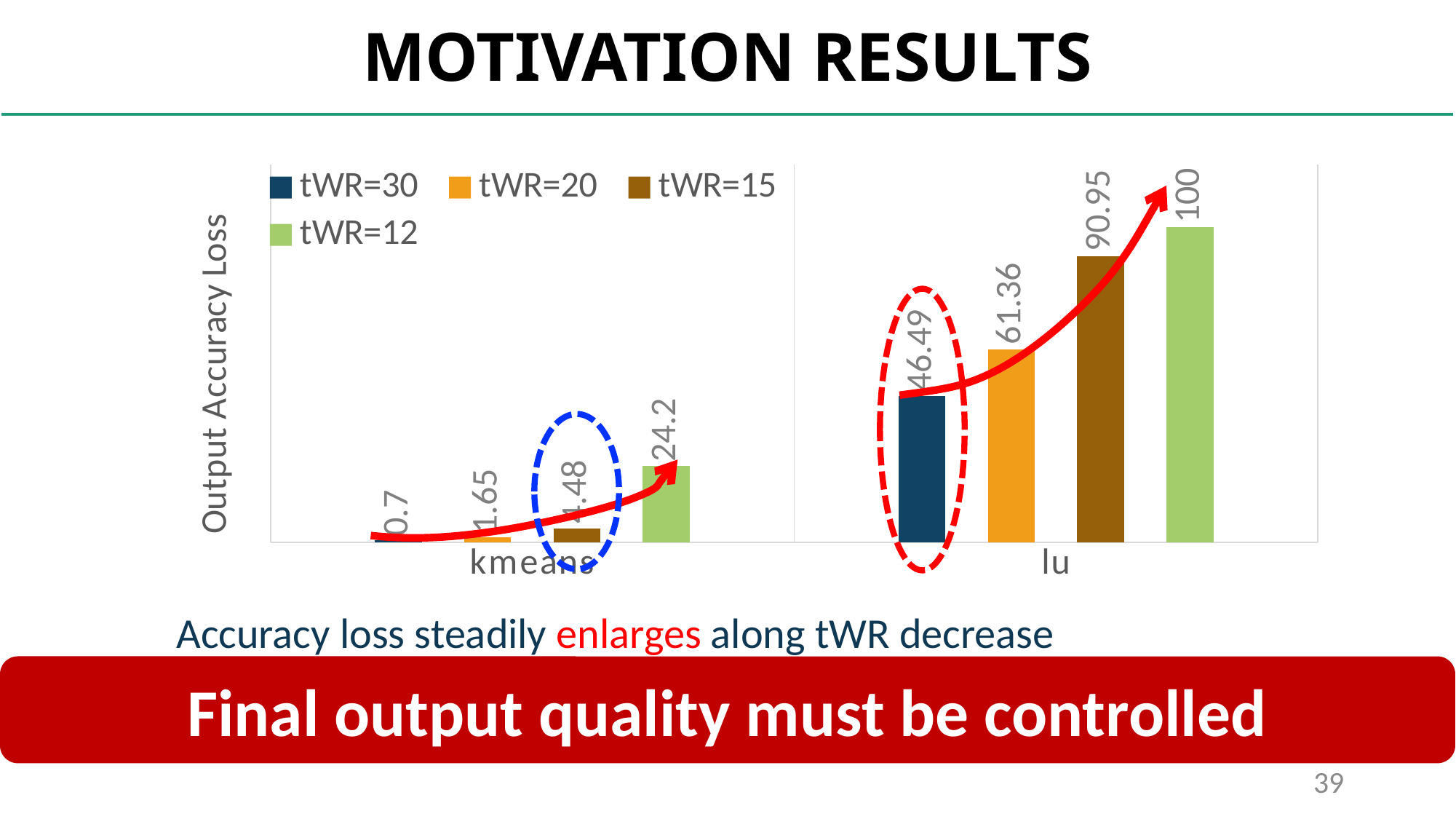
Which tWR setting gives the lowest Output Accuracy Loss for kmeans? tWR=30 How many categories are shown on the x axis? 2 What is the Output Accuracy Loss for lu at tWR=30? 46.49 What is the Output Accuracy Loss for lu at tWR=15? 90.95 What is the Output Accuracy Loss for lu at tWR=20? 61.36 What is the label of the y axis? Output Accuracy Loss How many series does the legend list? 4 Which tWR setting gives the highest Output Accuracy Loss for lu? tWR=12 What is the Output Accuracy Loss for kmeans at tWR=12? 24.2 What kind of chart is shown on the slide? bar chart Which is larger: the Output Accuracy Loss for kmeans at tWR=12 or for lu at tWR=30? lu at tWR=30 What is the difference between the Output Accuracy Loss for lu at tWR=12 and at tWR=30? 53.51